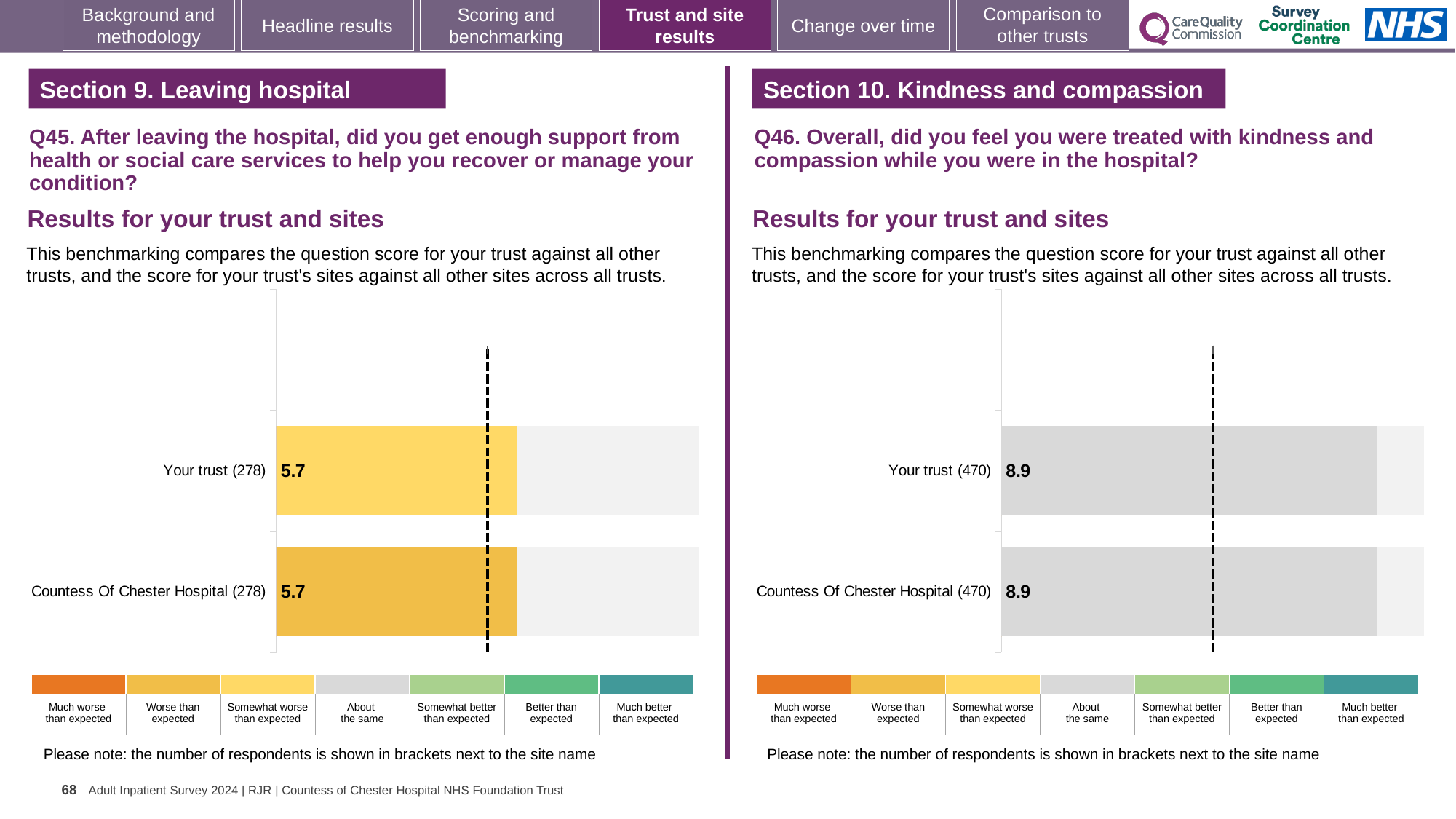
On the Q45 chart (left), what is the difference between the score for Your trust and the score for Countess Of Chester Hospital? 0 What kind of chart is used for the Q45 results on the left? Bar chart On the Q45 chart (left), what is the score for Your trust? 5.7 On the Q46 chart (right), what is the score for Your trust? 8.9 On the Q46 chart (right), what is the score for Countess Of Chester Hospital? 8.9 How many bars are plotted on the Q45 chart (left)? 2 On the Q45 chart (left), how many respondents are shown in brackets for Your trust? 278 On the Q46 chart (right), which benchmark category does the grey colour of the Your trust bar correspond to in the legend? About the same On the Q46 chart (right), how many respondents are shown in brackets for Countess Of Chester Hospital? 470 On the Q45 chart (left), what is the score for Countess Of Chester Hospital? 5.7 On the Q46 chart (right), what is the difference between the score for Your trust and the score for Countess Of Chester Hospital? 0 How many bars are plotted on the Q46 chart (right)? 2